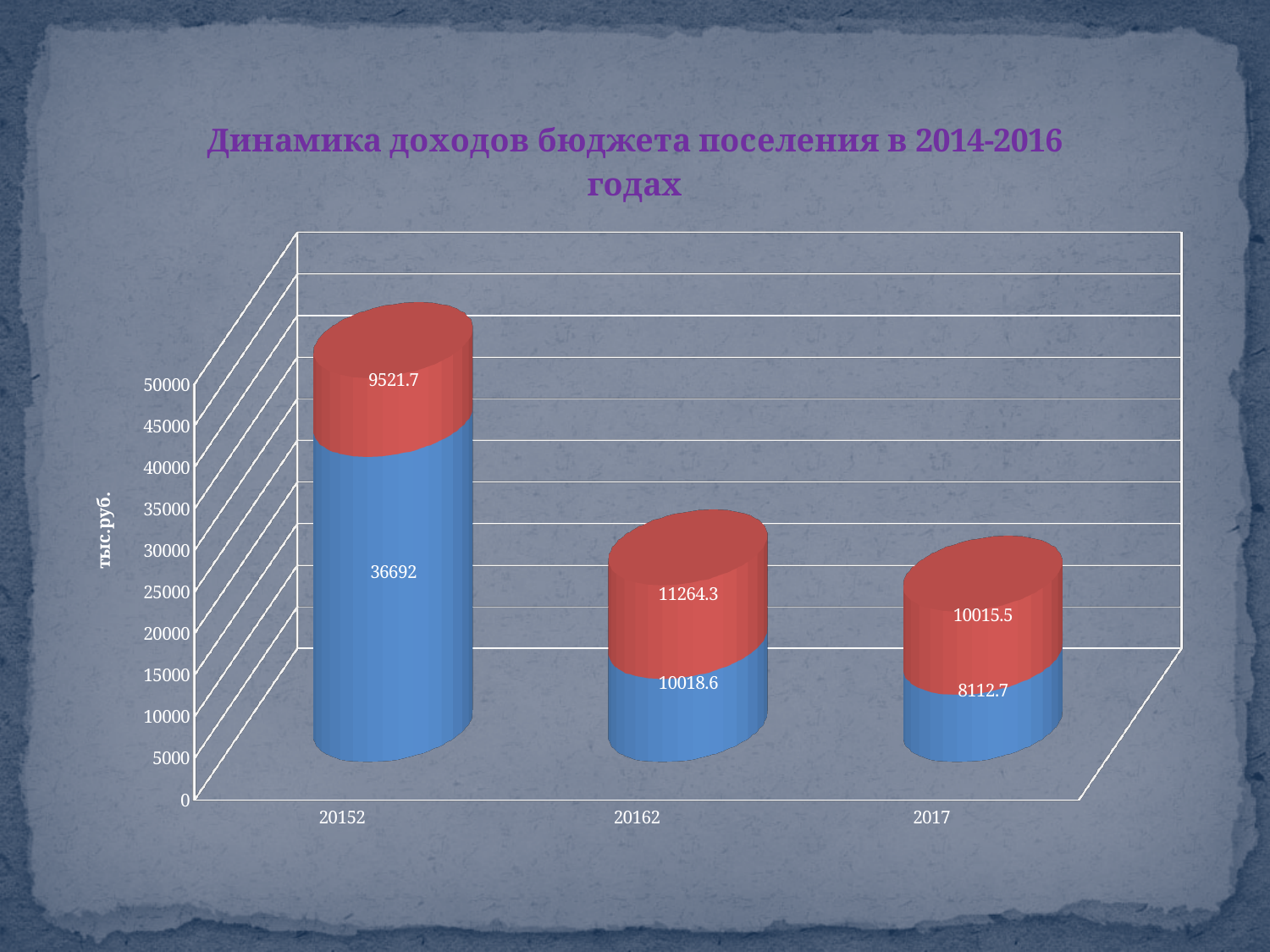
What is the total of the stacked bar for the category 20152? 46213.7 What is the value of the red (top) segment for the category 2017? 10015.5 Which category has the largest blue (bottom) segment? 20152 What is the value of the red (top) segment for the category 20162? 11264.3 How many categories are shown on the x axis of the chart? 3 What is the total of the stacked bar for the category 2017? 18128.2 What kind of chart is shown on the slide? Stacked bar chart What is the value of the blue (bottom) segment for the category 20152? 36692 What is the value of the blue (bottom) segment for the category 2017? 8112.7 What is the difference between the red segment for 20162 and the red segment for 2017? 1248.8 For the category 20162, which segment is larger, the blue one or the red one? The red one What is the label on the vertical axis of the chart? тыс.руб.